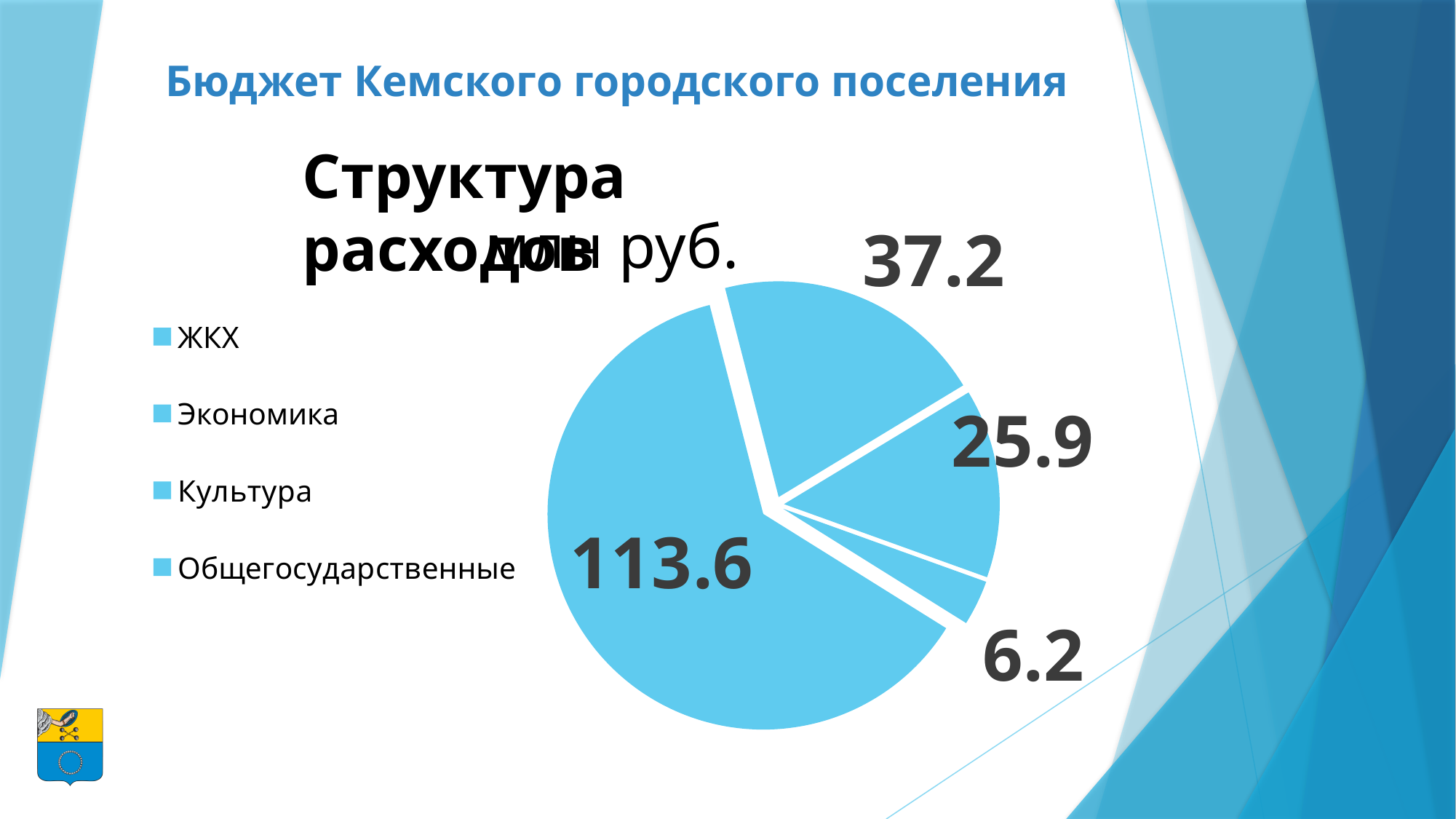
How many entries does the legend of the pie chart list? 4 What is the difference between the slices labelled 25.9 and 6.2? 19.7 Is the largest slice of the pie chart greater or less than 100? greater How many slices does the pie chart have? 4 What is the difference between the largest slice (113.6) and the slice labelled 37.2? 76.4 What is the total of all four values labelled on the pie chart? 182.9 What are the four legend entries of the pie chart, in order? ЖКХ, Экономика, Культура, Общегосударственные What kind of chart is shown on the slide? pie chart What is the smallest value labelled on the pie chart? 6.2 What is the title of the pie chart? Структура расходов Which is larger, the slice labelled 37.2 or the slice labelled 25.9? 37.2 What is the largest value labelled on the pie chart? 113.6